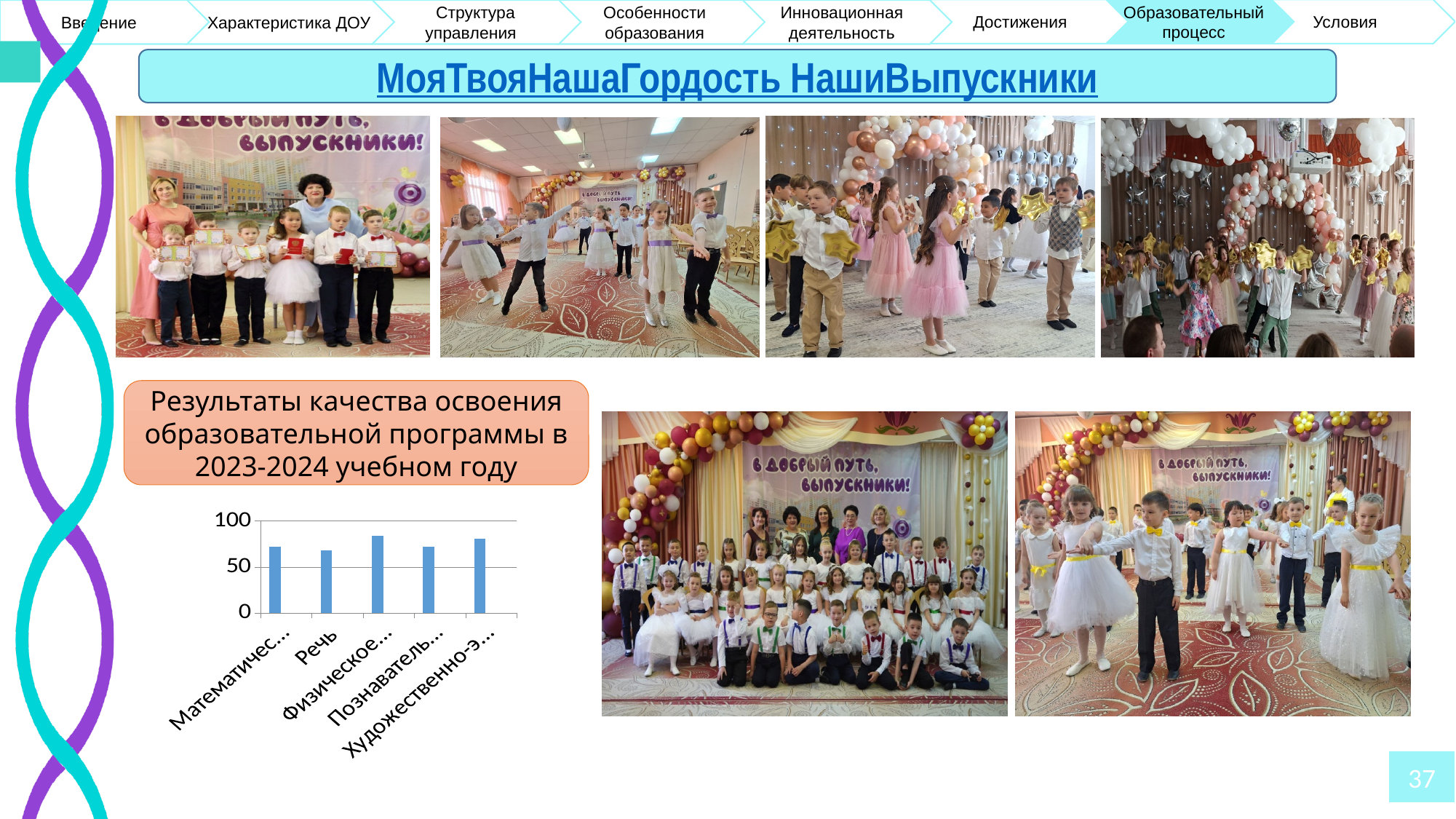
Which is larger: the value for 'Речь' or the value for the last bar ('Художественно-э...')? Художественно-э... Which is larger: the value for 'Речь' or the value for the third bar ('Физическое...')? Физическое... What kind of chart is shown under the heading 'Результаты качества освоения образовательной программы в 2023-2024 учебном году'? bar chart How many bars does the chart on the slide have? 5 What is the highest tick value shown on the vertical axis of the chart? 100 Is the value for 'Речь' greater or less than 100? less Is the value for the first bar ('Математичес...') greater or less than 100? less Is the value for the third bar ('Физическое...') greater or less than 50? greater What colour are the bars in the chart? blue